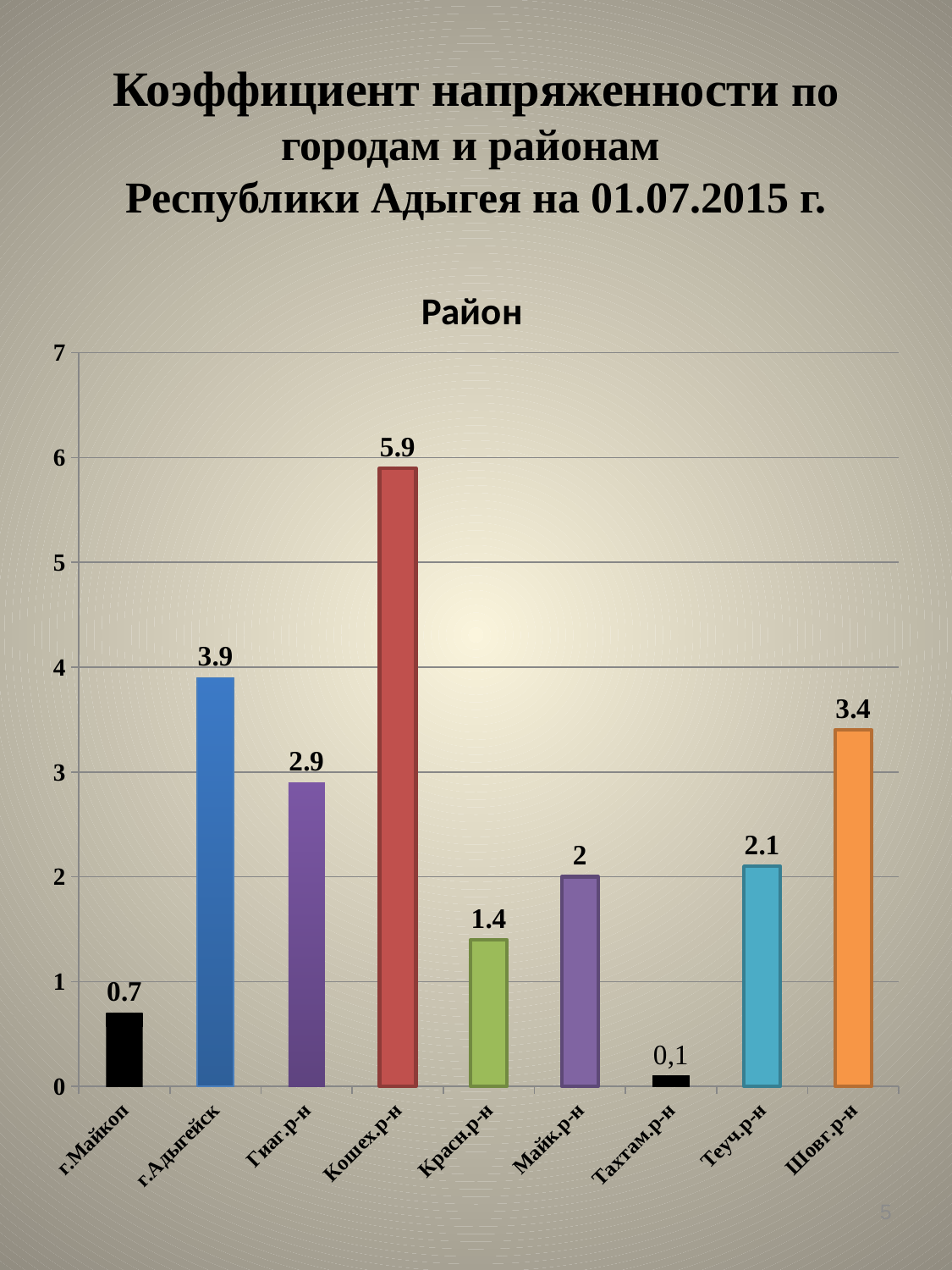
Which is larger, the value for Гиаг.р-н or the value for Шовг.р-н? Шовг.р-н What is the value for Тахтам.р-н? 0,1 How many categories are shown on the x axis? 9 What kind of chart is shown on the slide? bar chart Is the value for Красн.р-н greater or less than 2? less What is the value for Кошех.р-н? 5.9 Which category has the highest value? Кошех.р-н What is the title printed above the chart's plot area? Район What is the value for Шовг.р-н? 3.4 What is the difference between the values for Кошех.р-н and г.Адыгейск? 2 What is the value for г.Адыгейск? 3.9 Which category has the lowest value? Тахтам.р-н